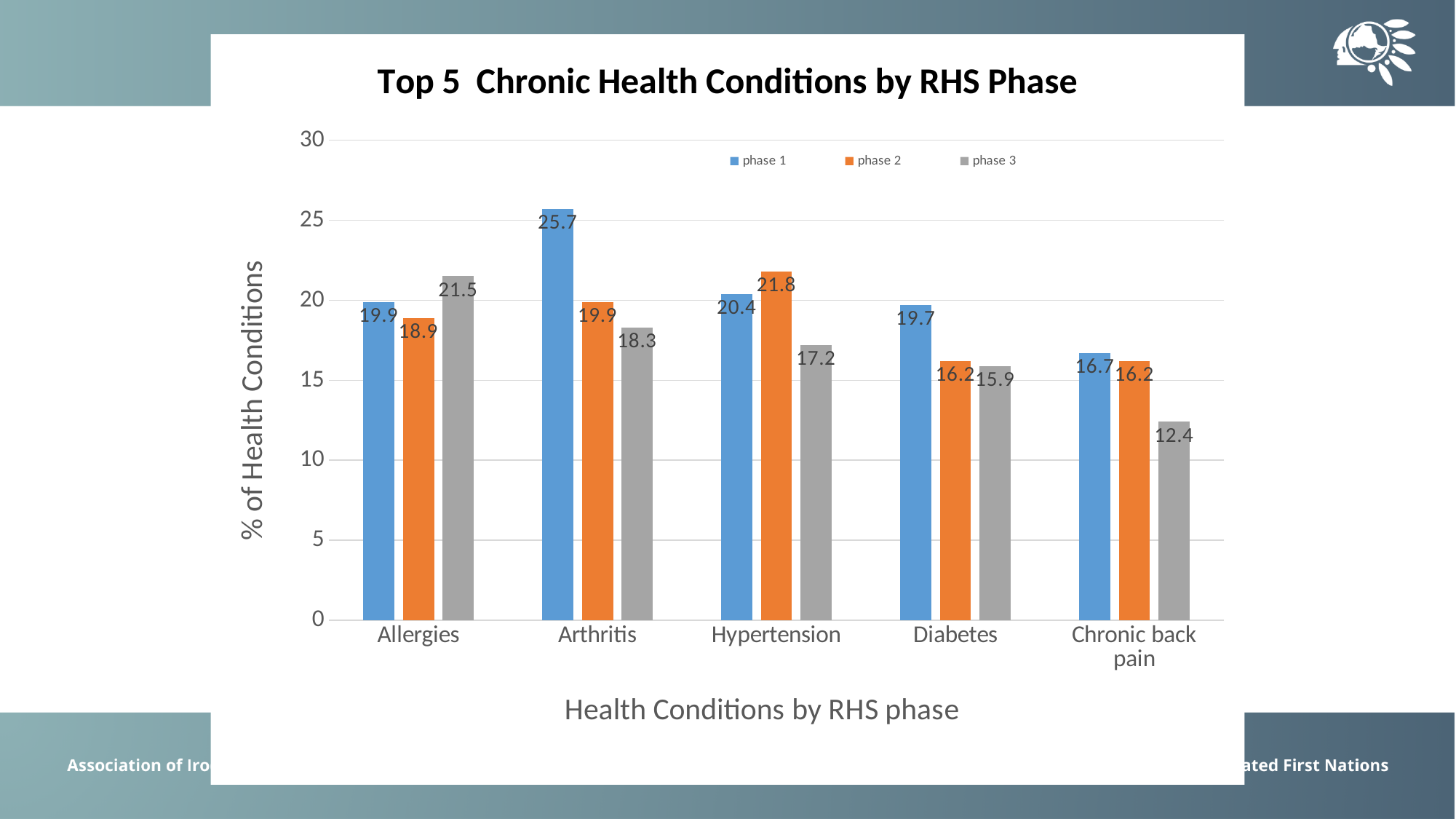
Which health condition has the highest phase 1 value? Arthritis What kind of chart is shown on the slide? bar chart How many series does the legend list? 3 How many health conditions are shown on the x axis? 5 Which is larger for Allergies: the phase 1 value or the phase 3 value? phase 3 What is the phase 1 value for Arthritis? 25.7 Is the phase 3 value for Hypertension greater or less than 20? less What is the difference between the phase 1 and phase 3 values for Arthritis? 7.4 What is the phase 3 value for Chronic back pain? 12.4 What is the title of the chart? Top 5 Chronic Health Conditions by RHS Phase What is the phase 2 value for Hypertension? 21.8 Which health condition has the lowest phase 3 value? Chronic back pain